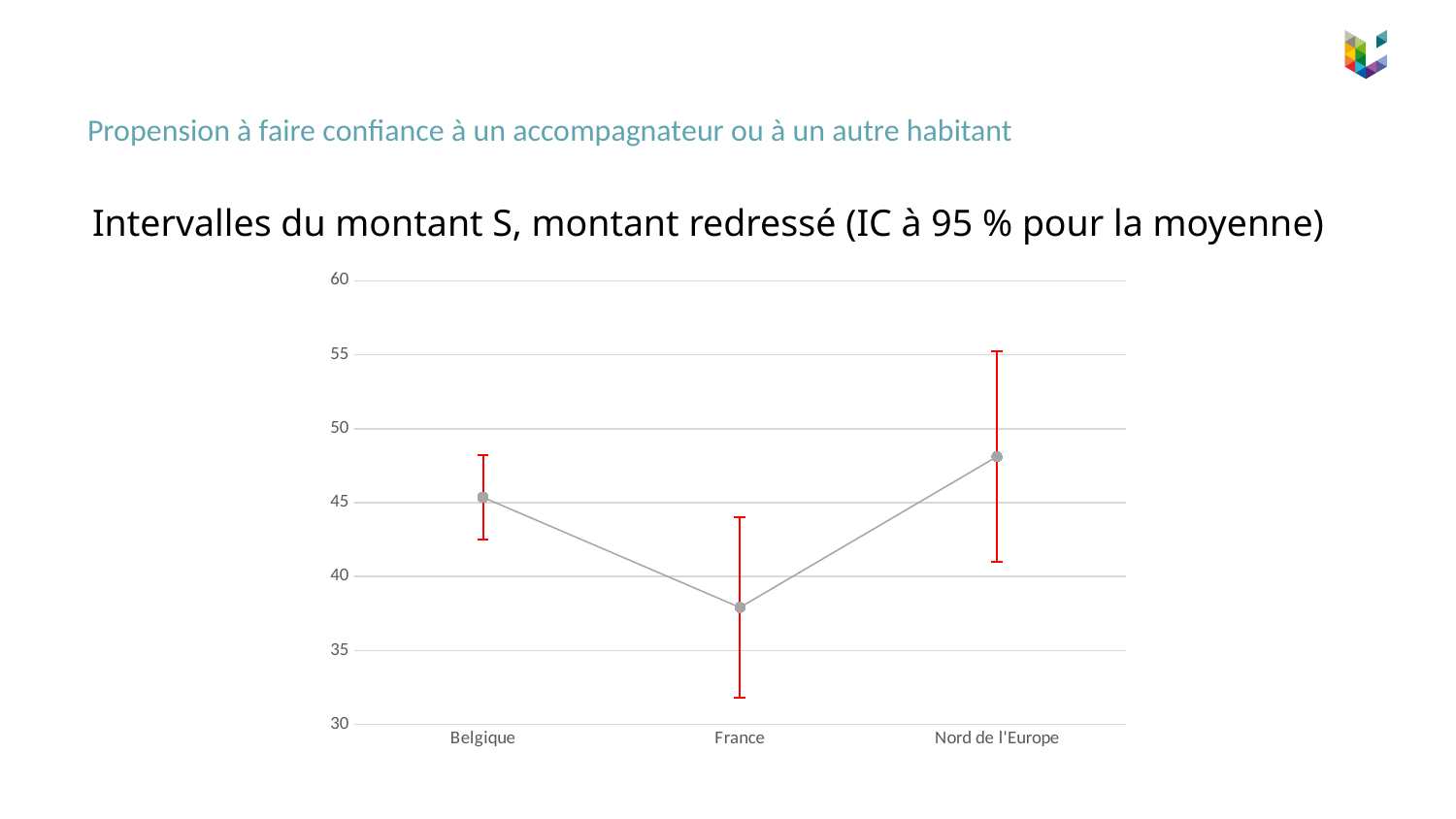
What is the highest value shown on the vertical axis? 60 How many categories are plotted on the x axis? 3 Is the value for France greater or less than 40? less Which category has the lowest plotted mean value? France What kind of chart is shown on the slide? line chart Which has a larger plotted value, Belgique or France? Belgique Which category has the highest plotted mean value? Nord de l'Europe Which has a larger plotted value, Belgique or Nord de l'Europe? Nord de l'Europe What is the title of the chart? Intervalles du montant S, montant redressé (IC à 95 % pour la moyenne) Does the plotted value rise or fall from Belgique to France? fall Is the value for Nord de l'Europe greater or less than 50? less